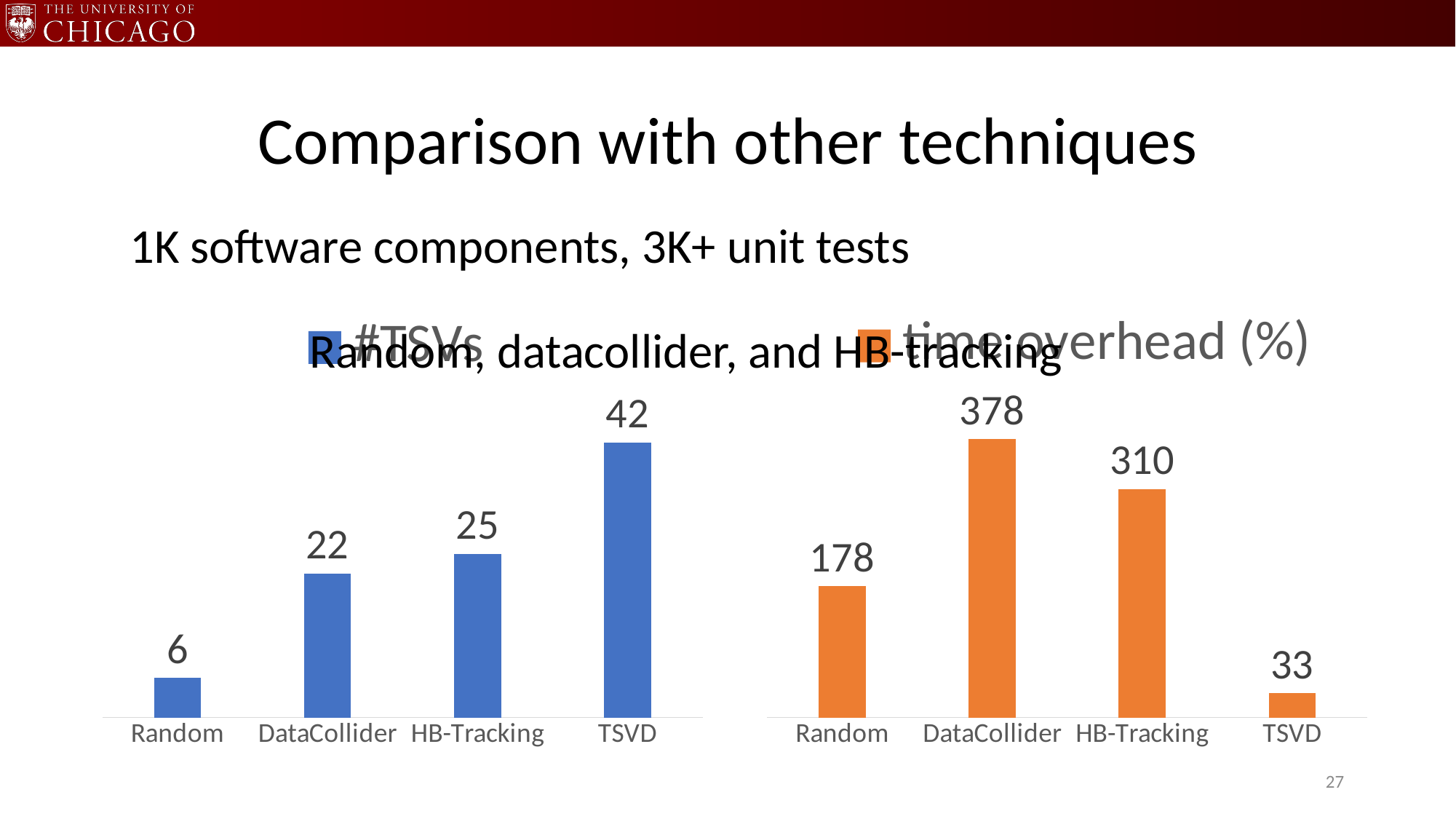
What type of chart is shown on the slide? Bar chart Which technique has the highest time overhead (%)? DataCollider What is the difference in #TSVs between TSVD and HB-Tracking? 17 What is the #TSVs value for TSVD? 42 Which technique has the highest #TSVs? TSVD What is the #TSVs value for Random? 6 Which has a larger time overhead (%), Random or HB-Tracking? HB-Tracking How many techniques are compared in the chart? 4 What is the time overhead (%) value for DataCollider? 378 Which technique has the lowest time overhead (%)? TSVD What is the time overhead (%) value for TSVD? 33 What is the difference in time overhead (%) between DataCollider and HB-Tracking? 68